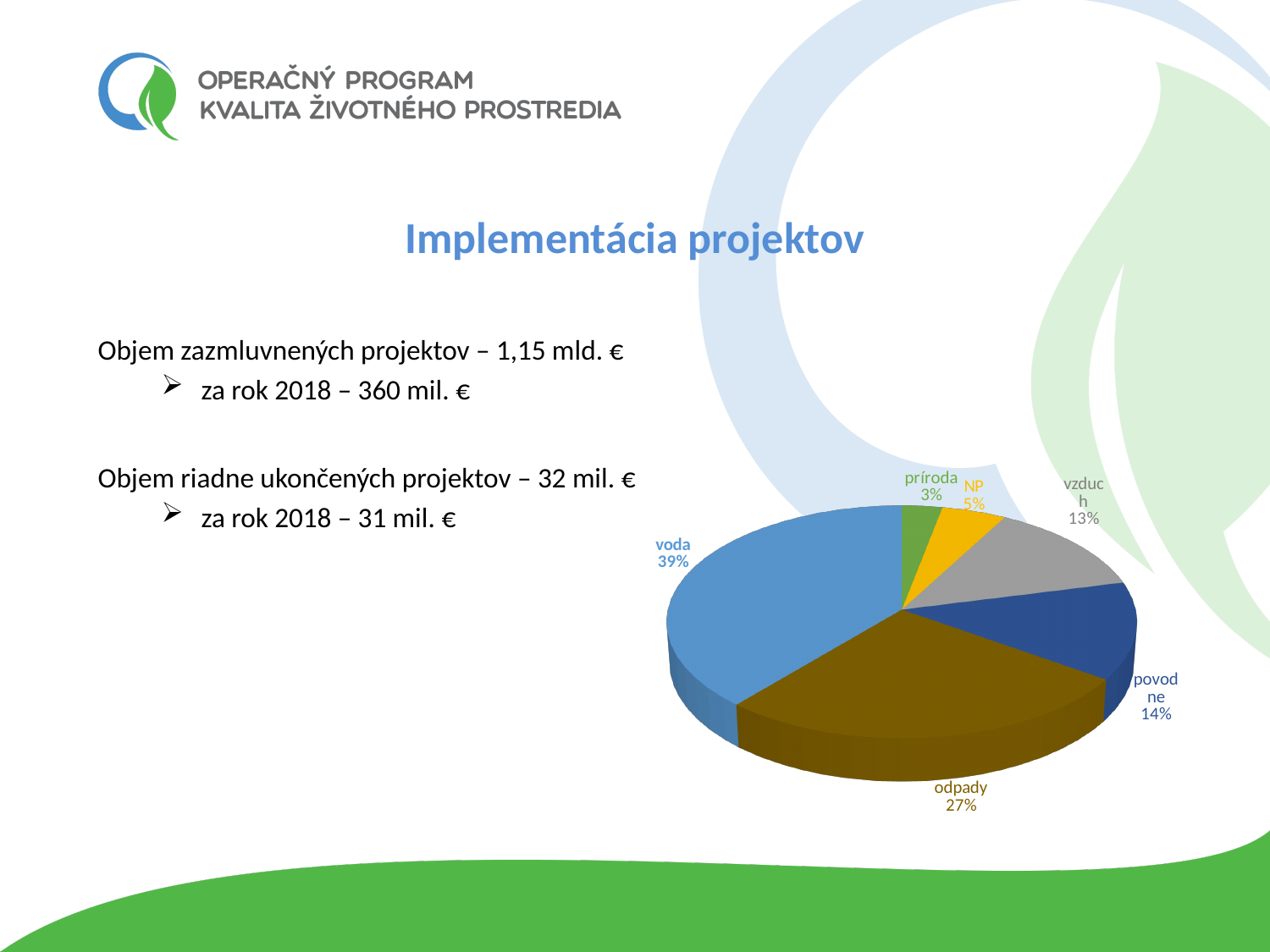
What percentage is shown for "príroda"? 3% What share of the pie does the "odpady" slice represent? 27% Which is larger, the "povodne" slice or the "NP" slice? povodne What share of the pie does the "voda" slice represent? 39% What percentage is shown for "vzduch"? 13% Which slice of the pie is the largest? voda What kind of chart is shown on the slide? pie chart What percentage is shown for "NP"? 5% What percentage is shown for "povodne"? 14% What is the difference in percentage points between the "voda" and "odpady" slices? 12 Which slice of the pie is the smallest? príroda How many slices does the pie chart have? 6